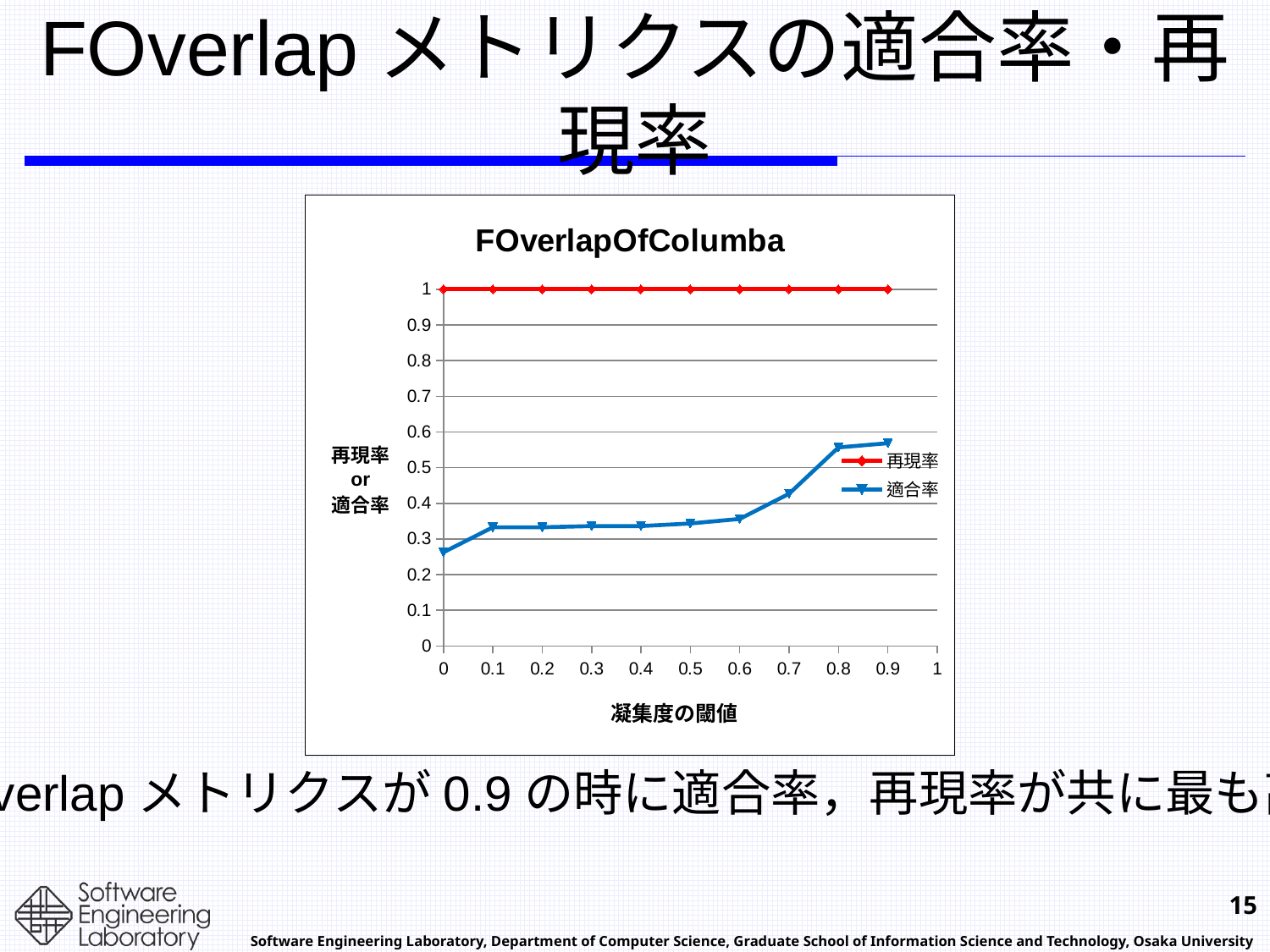
Is the value of 適合率 at 凝集度の閾値 0.9 greater or less than 0.5? greater Is the value of 適合率 at 凝集度の閾値 0 greater or less than 0.3? less Does the 適合率 series rise or fall as 凝集度の閾値 increases from 0 to 0.9? rise What kind of chart is shown on the slide? line chart How many data points does the 適合率 series have? 10 What is the value of 再現率 at a 凝集度の閾値 of 0.5? 1 Which series has the higher value at 凝集度の閾値 0.4, 再現率 or 適合率? 再現率 Is the value of 適合率 at 凝集度の閾値 0.7 greater or less than 0.5? less What is the title of the chart? FOverlapOfColumba At which 凝集度の閾値 is the 適合率 series lowest? 0 Which series is drawn in red? 再現率 How many series does the legend list? 2